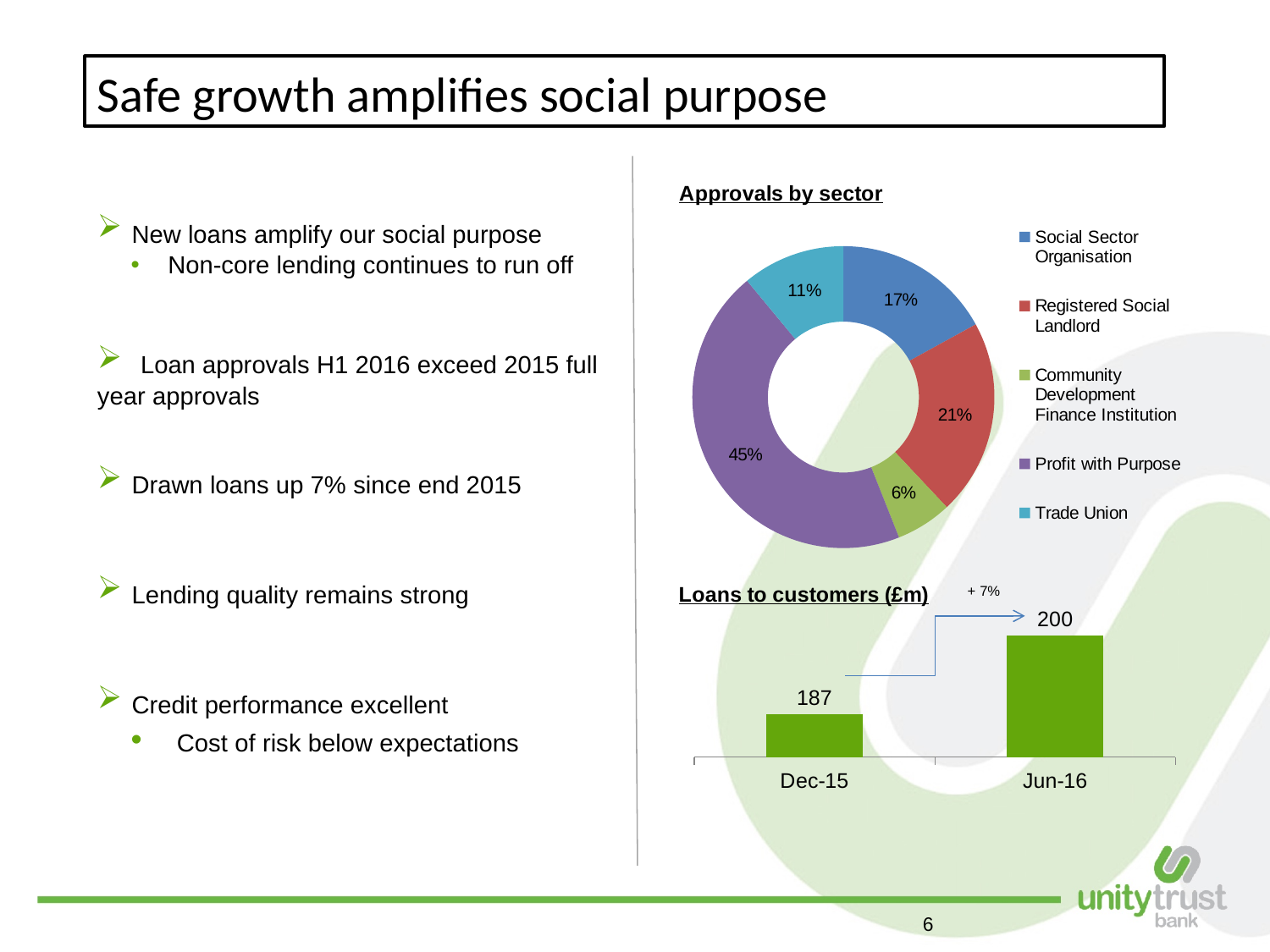
In the 'Loans to customers (£m)' chart, what is the value for Jun-16? 200 In the 'Loans to customers (£m)' chart, what is the value for Dec-15? 187 What kind of chart is the 'Loans to customers (£m)' chart? Bar chart In the 'Approvals by sector' chart, which is larger: Social Sector Organisation or Trade Union? Social Sector Organisation In the 'Approvals by sector' chart, what share of approvals is Profit with Purpose? 45% What kind of chart is the 'Approvals by sector' chart? Doughnut chart In the 'Approvals by sector' chart, how many sectors does the legend list? 5 In the 'Approvals by sector' chart, what share of approvals is Trade Union? 11% In the 'Approvals by sector' chart, which sector has the smallest share? Community Development Finance Institution In the 'Loans to customers (£m)' chart, what is the difference between Jun-16 and Dec-15? 13 In the 'Approvals by sector' chart, what share of approvals is Registered Social Landlord? 21% In the 'Approvals by sector' chart, which sector has the largest share? Profit with Purpose